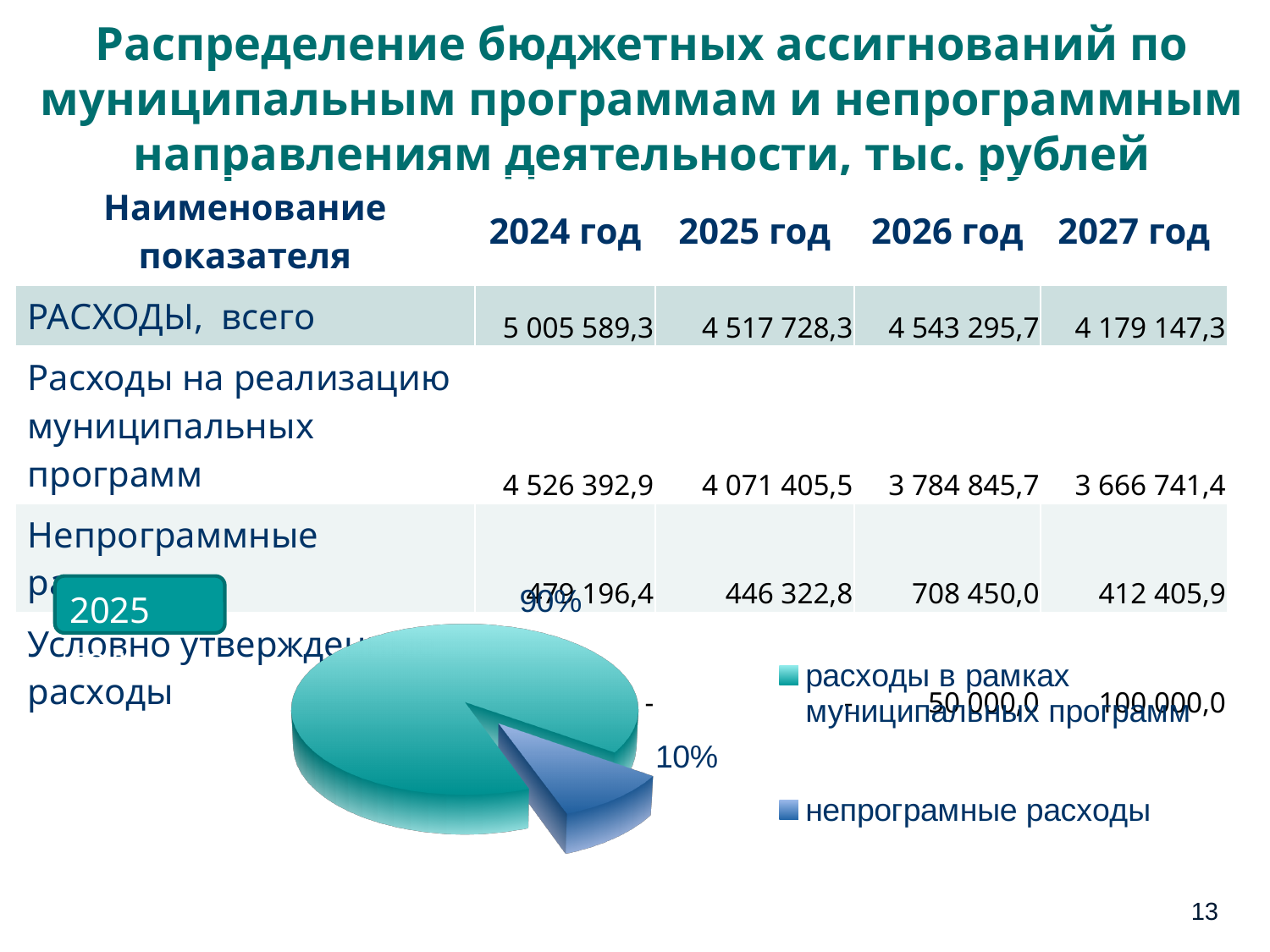
In the pie chart, which is larger: расходы в рамках муниципальных программ or непрограмные расходы? расходы в рамках муниципальных программ What kind of chart is shown on the slide? pie chart How many series does the pie chart's legend list? 2 How many slices does the pie chart have? 2 What share of the pie chart is labelled for непрограмные расходы? 10% Which slice of the pie chart is the smallest? непрограмные расходы What share of the pie chart is labelled for расходы в рамках муниципальных программ? 90% What colour is the непрограмные расходы slice in the pie chart? blue Which slice of the pie chart is the largest? расходы в рамках муниципальных программ What is the difference in percentage points between the two slices of the pie chart? 80 Which year is the pie chart labelled with? 2025